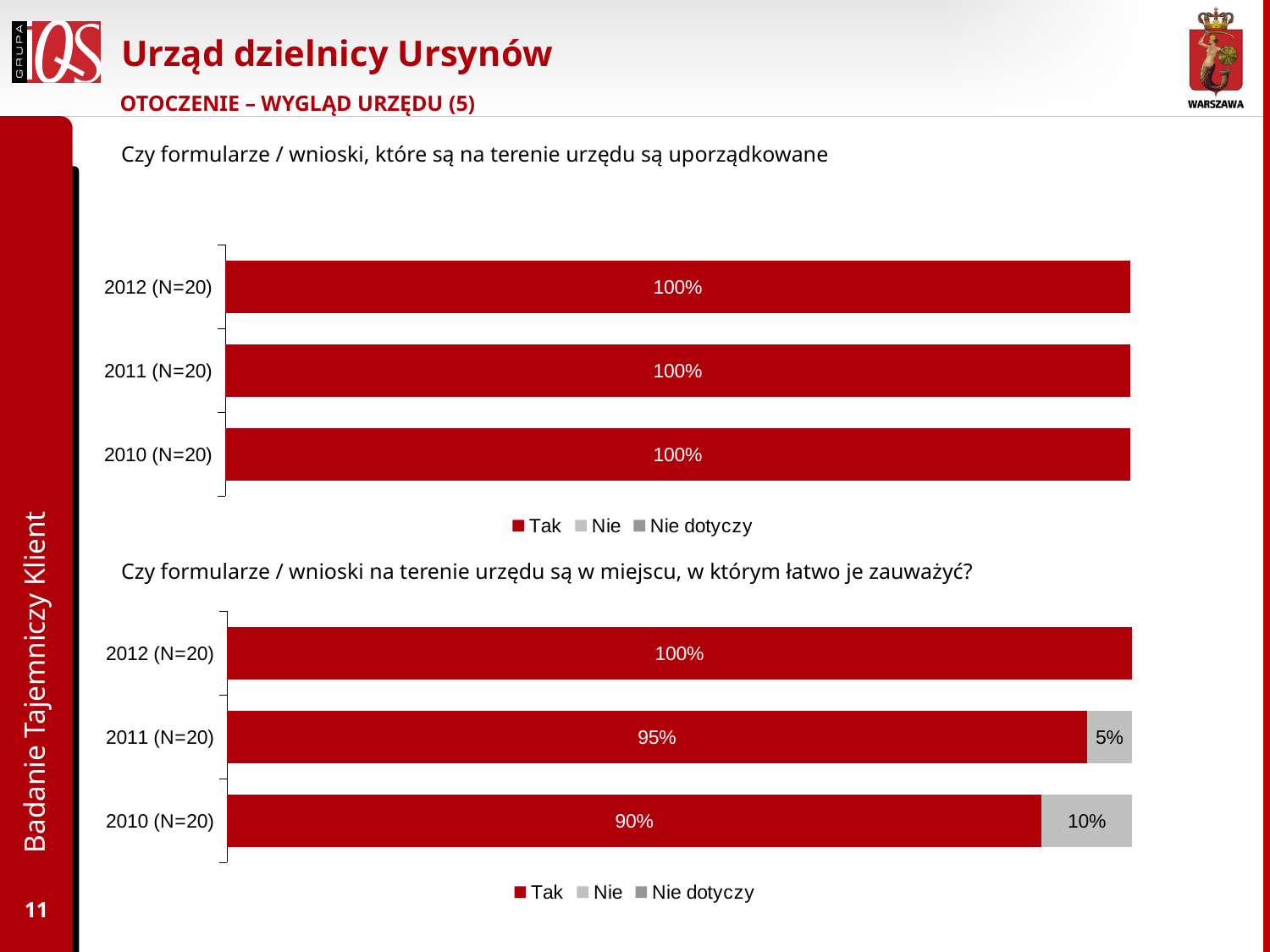
How many series does the legend of the bottom chart ("Czy formularze / wnioski na terenie urzędu są w miejscu, w którym łatwo je zauważyć?") list? 3 In the bottom chart ("Czy formularze / wnioski na terenie urzędu są w miejscu, w którym łatwo je zauważyć?"), what is the value for Tak in 2010 (N=20)? 90% In the bottom chart ("Czy formularze / wnioski na terenie urzędu są w miejscu, w którym łatwo je zauważyć?"), what is the total of the stacked bar for 2010 (N=20)? 100% In the bottom chart ("Czy formularze / wnioski na terenie urzędu są w miejscu, w którym łatwo je zauważyć?"), what is the value for Nie in 2011 (N=20)? 5% In the bottom chart ("Czy formularze / wnioski na terenie urzędu są w miejscu, w którym łatwo je zauważyć?"), is the Tak value larger for 2011 (N=20) or 2010 (N=20)? 2011 (N=20) In the top chart ("Czy formularze / wnioski, które są na terenie urzędu są uporządkowane"), what is the value for Tak in 2011 (N=20)? 100% How many year categories does the top chart ("Czy formularze / wnioski, które są na terenie urzędu są uporządkowane") show? 3 In the bottom chart ("Czy formularze / wnioski na terenie urzędu są w miejscu, w którym łatwo je zauważyć?"), what is the difference between the Tak values for 2011 (N=20) and 2010 (N=20)? 5% In the bottom chart ("Czy formularze / wnioski na terenie urzędu są w miejscu, w którym łatwo je zauważyć?"), what is the value for Tak in 2012 (N=20)? 100% In the bottom chart ("Czy formularze / wnioski na terenie urzędu są w miejscu, w którym łatwo je zauważyć?"), which year has the lowest value for Tak? 2010 (N=20) What kind of chart is the top chart ("Czy formularze / wnioski, które są na terenie urzędu są uporządkowane")? Bar chart In the bottom chart ("Czy formularze / wnioski na terenie urzędu są w miejscu, w którym łatwo je zauważyć?"), which year has the highest value for Nie? 2010 (N=20)